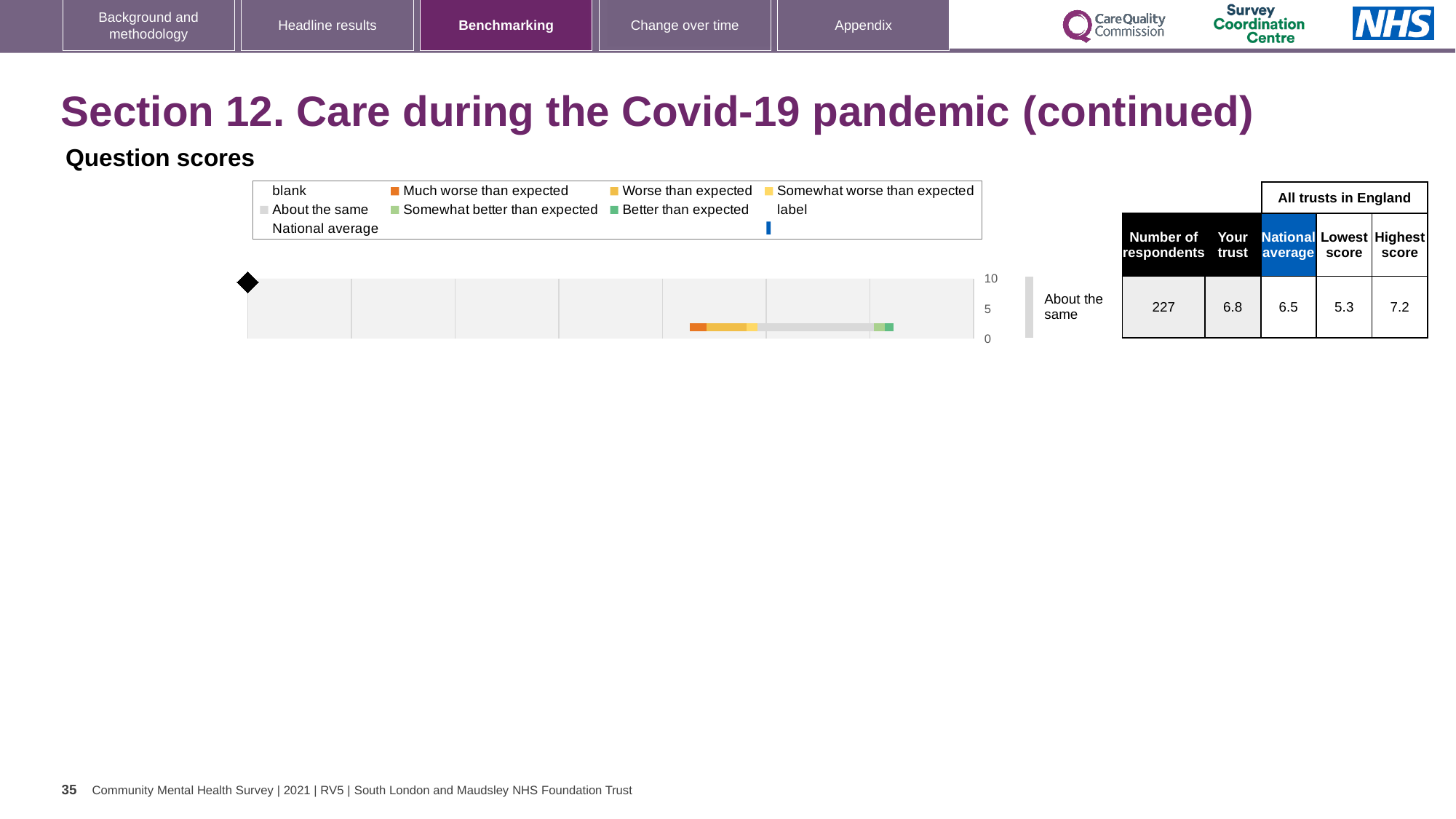
What is the difference between the highest score and the lowest score shown for this question? 1.9 How many respondents are shown for the question row? 227 What benchmark category label is shown next to the plotted question row? About the same How many question rows are plotted in the chart on this slide? 1 What is the maximum value shown on the chart's score axis? 10 What is the 'Your trust' score shown for the question row on this slide? 6.8 Which is larger for this question: the 'Your trust' score or the national average? Your trust What is the lowest score among all trusts in England shown for this question? 5.3 By how much does the 'Your trust' score exceed the national average for this question? 0.3 What is the national average score shown for the question row? 6.5 What kind of chart is used to show the question score on this slide? Bar chart What is the highest score among all trusts in England shown for this question? 7.2